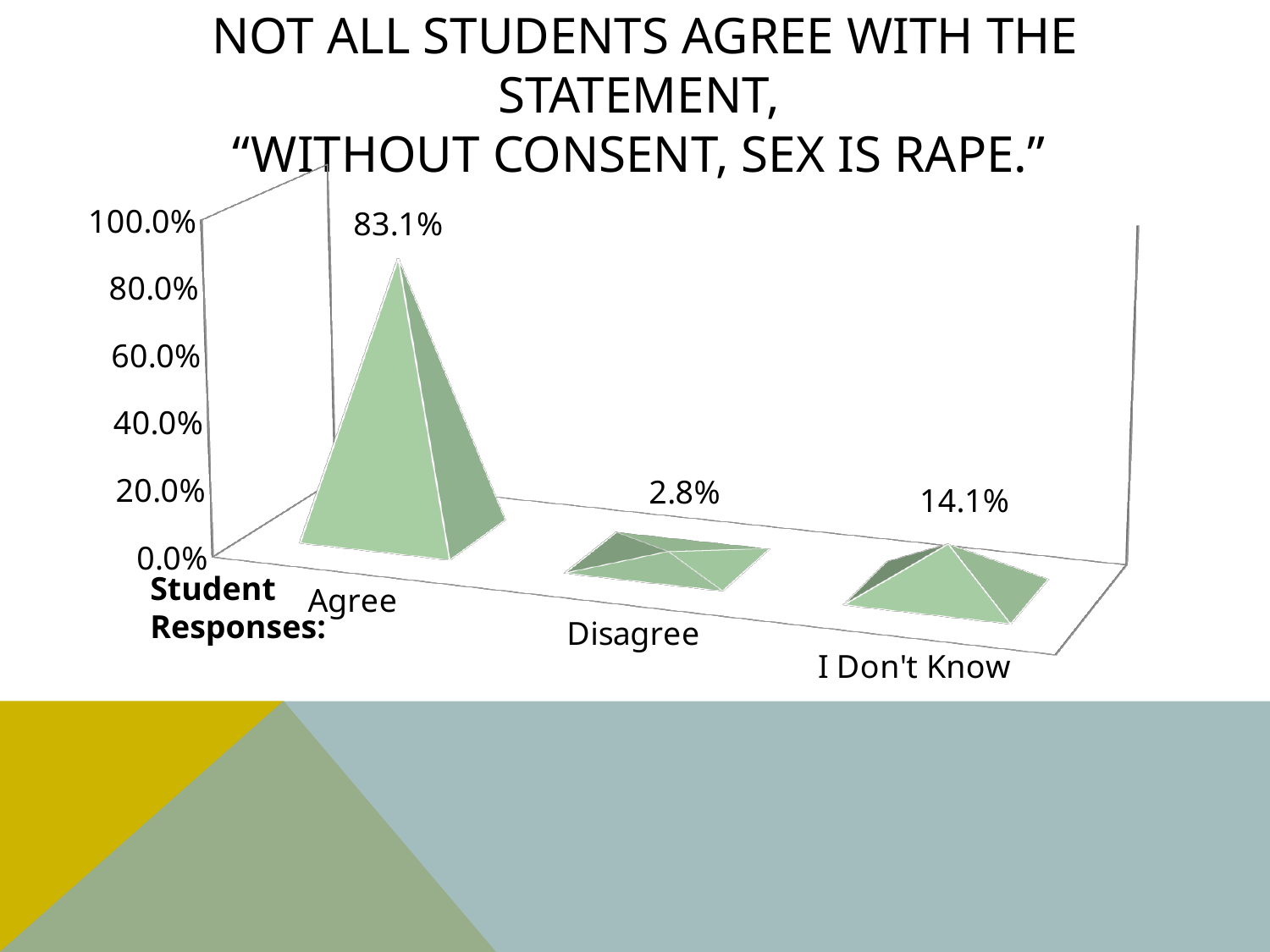
Which response category has the highest percentage? Agree What kind of chart is shown on the slide? Bar chart Which is larger, the percentage for "Disagree" or for "I Don't Know"? I Don't Know What percentage of students responded "Disagree"? 2.8% What is the label shown next to the category axis of the chart? Student Responses: Is the value for "Agree" greater or less than 80.0%? greater How many response categories are shown on the chart? 3 What is the difference in percentage points between "I Don't Know" and "Disagree"? 11.3% What percentage of students responded "Agree"? 83.1% What is the difference in percentage points between "Agree" and "I Don't Know"? 69.0% What percentage of students responded "I Don't Know"? 14.1% Which response category has the lowest percentage? Disagree